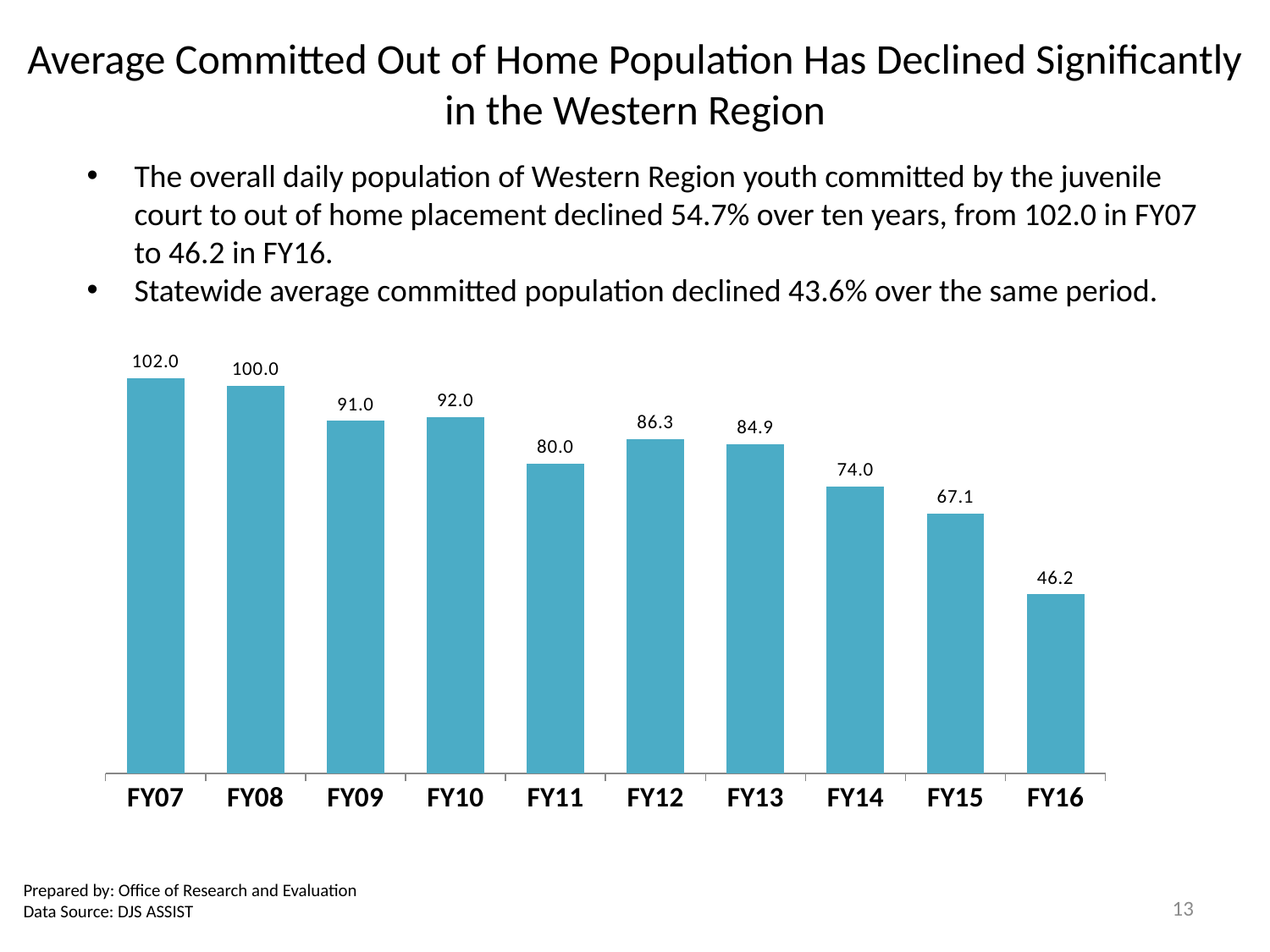
Which is larger, the value for FY09 or the value for FY10? FY10 What is the value for FY11? 80.0 What is the value for FY15? 67.1 What is the value for FY07? 102.0 Which fiscal year has the lowest value? FY16 What is the difference between the values for FY07 and FY16? 55.8 What kind of chart is shown on the slide? Bar chart Do the values generally rise or fall from FY07 to FY16? Fall What is the difference between the values for FY12 and FY13? 1.4 Which fiscal year has the highest value? FY07 How many fiscal years are shown on the chart? 10 Which is larger, the value for FY14 or the value for FY11? FY11